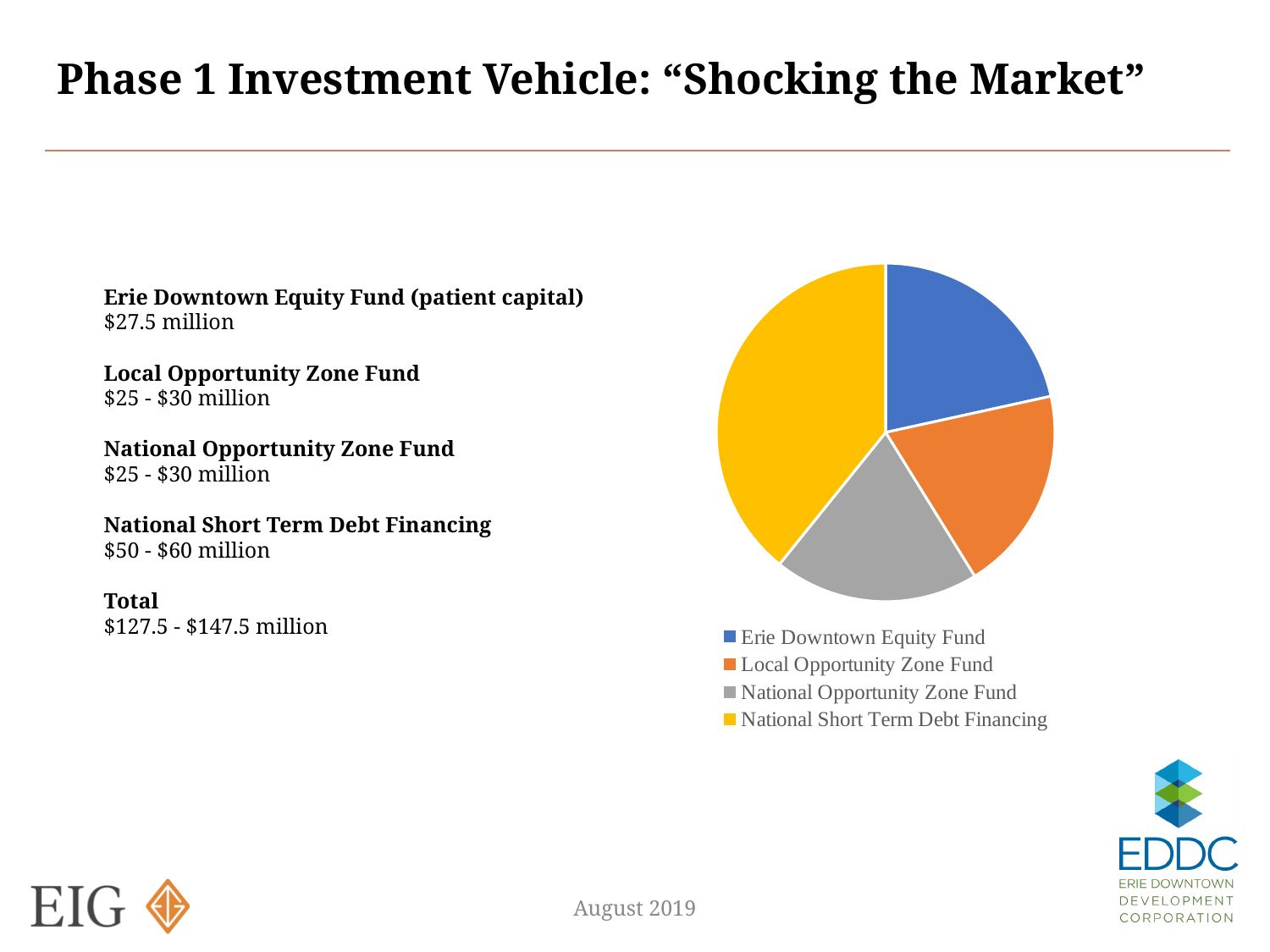
How many slices does the pie chart have? 4 How many entries does the pie chart's legend list? 4 What kind of chart is shown on the slide? Pie chart Which slice is larger: National Short Term Debt Financing or National Opportunity Zone Fund? National Short Term Debt Financing Which category is shown in grey in the pie chart? National Opportunity Zone Fund Which slice is larger: National Short Term Debt Financing or Erie Downtown Equity Fund? National Short Term Debt Financing Which slice is larger: National Short Term Debt Financing or Local Opportunity Zone Fund? National Short Term Debt Financing What colour is the Erie Downtown Equity Fund slice in the pie chart? Blue Which category has the largest slice of the pie chart? National Short Term Debt Financing